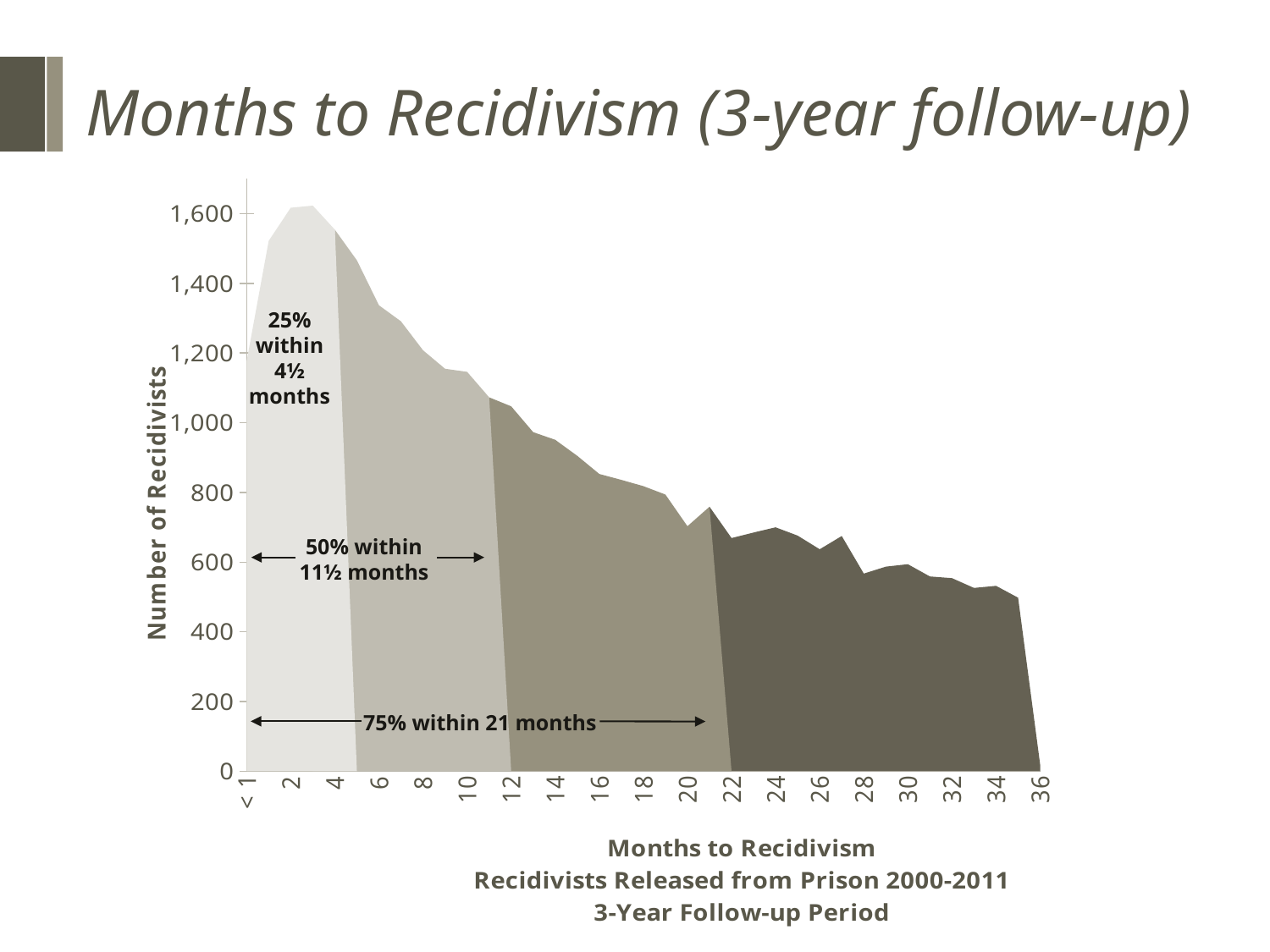
Within how many months did 25% of recidivists reoffend, according to the chart annotation? 4½ months Within how many months did 50% of recidivists reoffend, according to the chart annotation? 11½ months Is the number of recidivists at 36 months greater or less than 600? less What percentage of recidivists reoffended within 21 months, according to the chart annotation? 75% Is the number of recidivists at 24 months greater or less than 800? less What is the title of the slide's chart? Months to Recidivism (3-year follow-up) Is the number of recidivists at 30 months greater or less than 400? greater What is the label on the vertical axis of the chart? Number of Recidivists From month 4 onward, do the number of recidivists generally rise or fall as months to recidivism increase? fall What kind of chart is shown on the slide? area chart